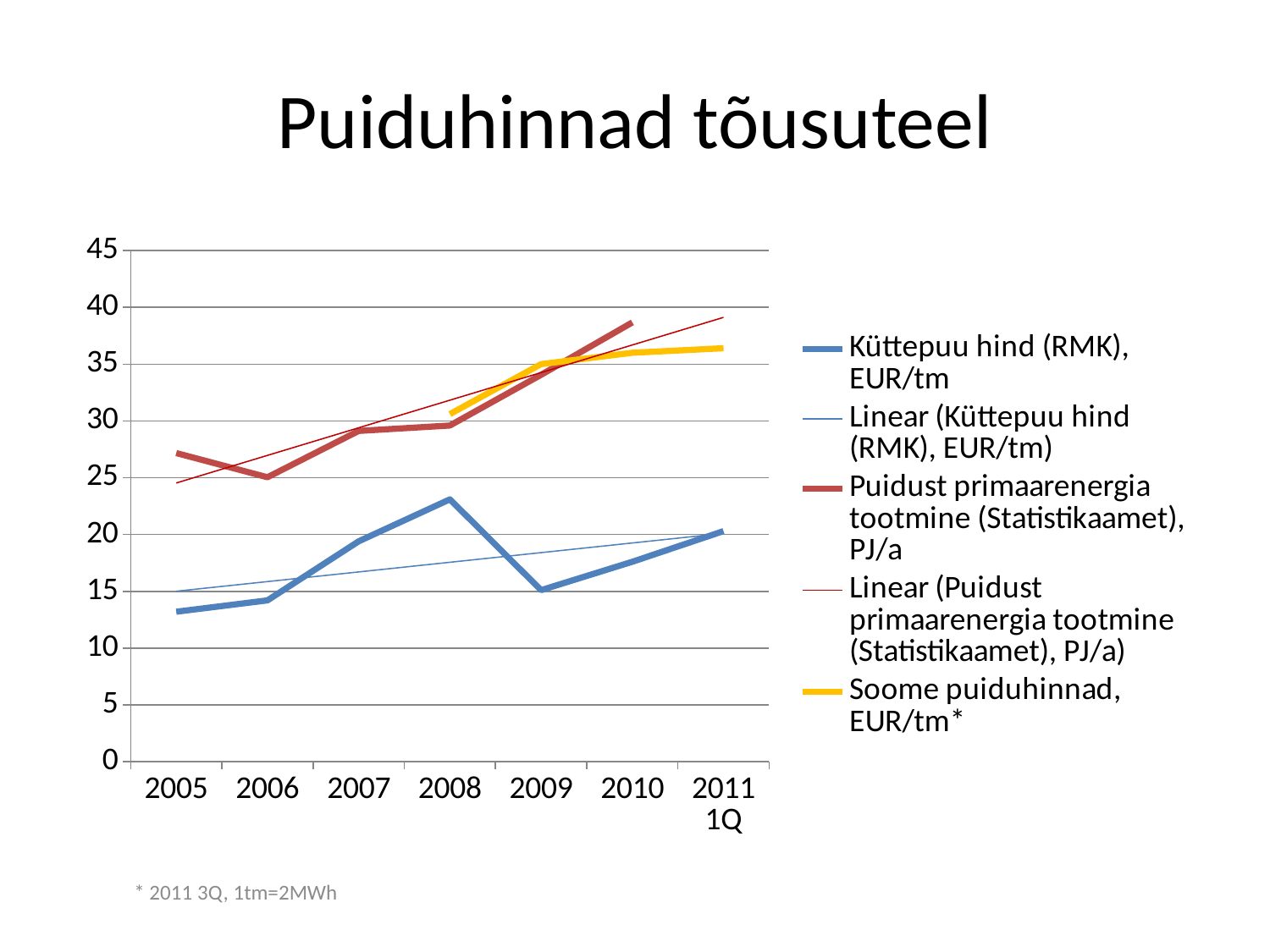
What is the title of the slide? Puiduhinnad tõusuteel Is the value for Puidust primaarenergia tootmine (Statistikaamet), PJ/a in 2010 greater or less than 35? greater How many series does the chart's legend list? 5 In which year is the Küttepuu hind (RMK), EUR/tm series at its lowest? 2005 Is the value for Küttepuu hind (RMK), EUR/tm in 2008 greater or less than 20? greater What kind of chart is shown on the slide? line chart In which year is the Puidust primaarenergia tootmine (Statistikaamet), PJ/a series at its lowest? 2006 How many categories are shown on the x axis of the chart? 7 Which is larger for Küttepuu hind (RMK), EUR/tm: the value in 2007 or the value in 2009? 2007 Is the value for Puidust primaarenergia tootmine (Statistikaamet), PJ/a in 2006 greater or less than 30? less In which year does the Küttepuu hind (RMK), EUR/tm series reach its highest value? 2008